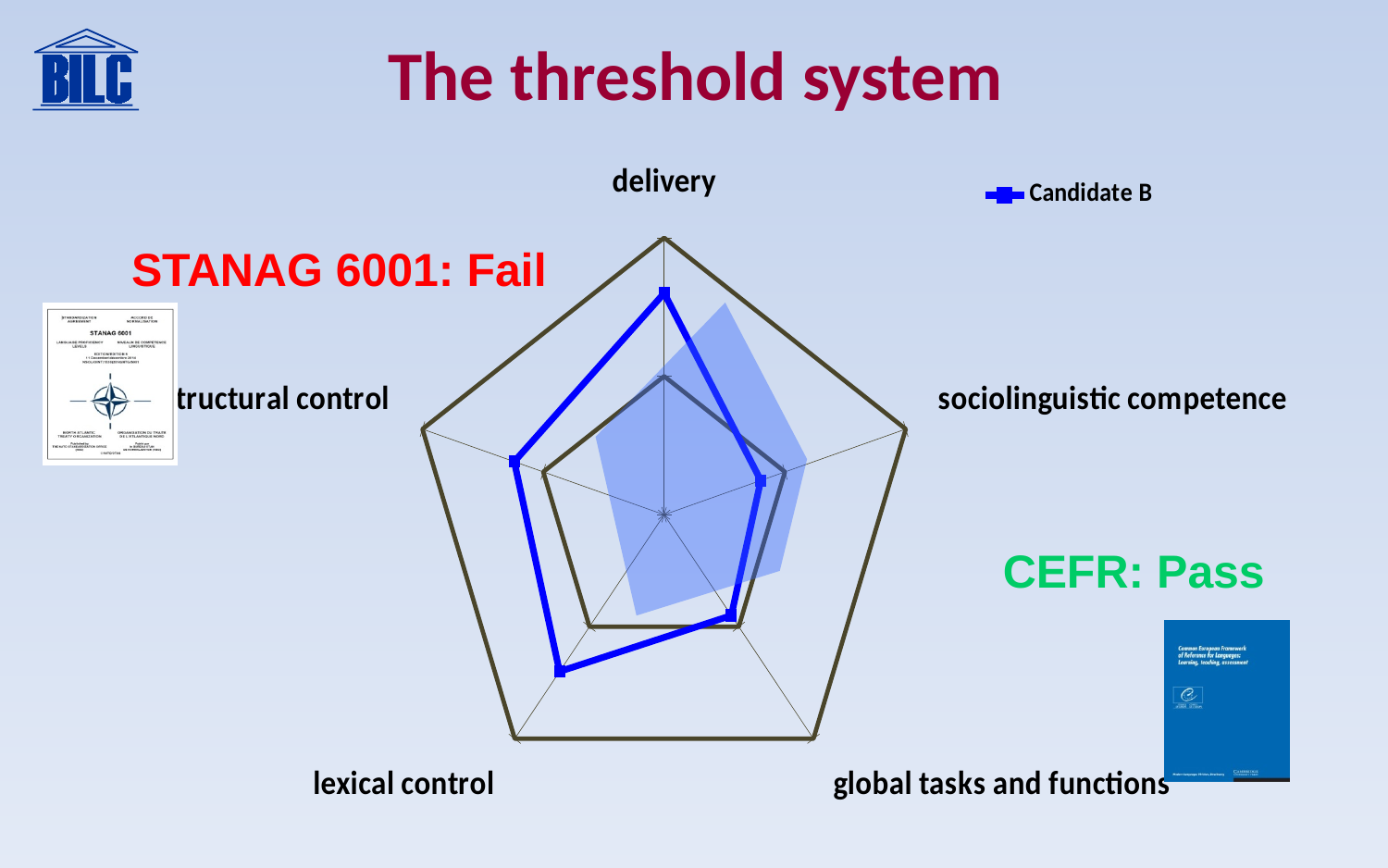
Which is larger for Candidate B, the value for delivery or the value for sociolinguistic competence? delivery Which is larger for Candidate B, the value for lexical control or the value for global tasks and functions? lexical control What kind of chart is shown on the slide? radar chart Which is larger for Candidate B, the value for lexical control or the value for sociolinguistic competence? lexical control What is the title of the slide containing the chart? The threshold system How many categories (axes) does the radar chart have? 5 Which category label appears at the top of the radar chart? delivery What series name appears in the chart legend? Candidate B How many series does the chart legend list? 1